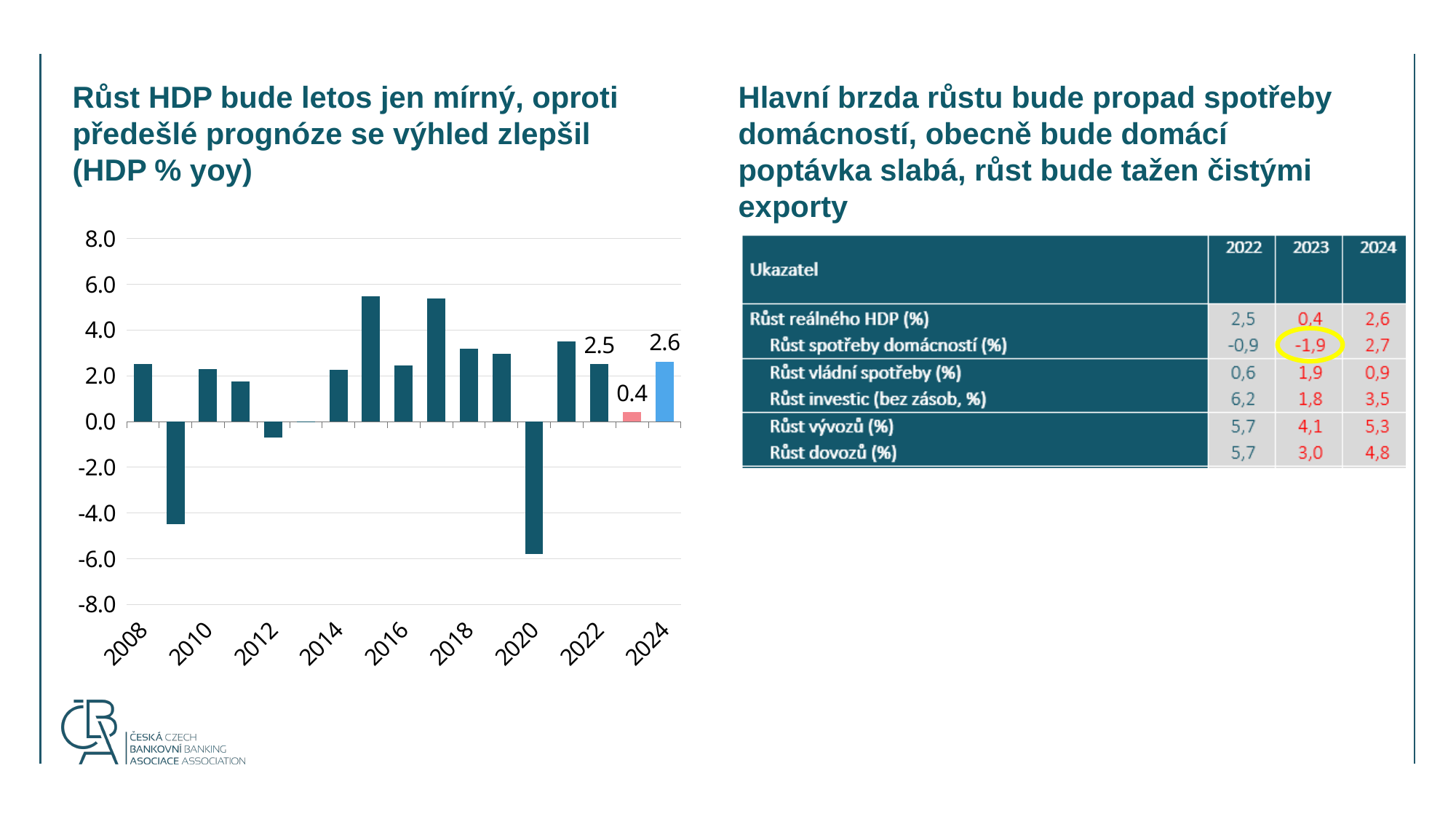
Does the value in the GDP growth chart rise or fall from 2022 to 2023? fall What colour is the bar for 2024 in the GDP growth chart? light blue Is the value for 2015 in the GDP growth chart greater or less than 4.0? greater What is the value for 2024 in the GDP growth chart? 2.6 What is the value for 2022 in the GDP growth chart? 2.5 What is the difference between the values for 2024 and 2023 in the GDP growth chart? 2.2 Which is larger in the GDP growth chart, the value for 2022 or the value for 2024? 2024 Which year has the lowest value in the GDP growth chart? 2020 Is the value for 2020 in the GDP growth chart greater or less than -4.0? less What is the value for 2023 in the GDP growth chart? 0.4 Is the value for 2009 in the GDP growth chart greater or less than -2.0? less What type of chart is shown on the left of the slide? bar chart